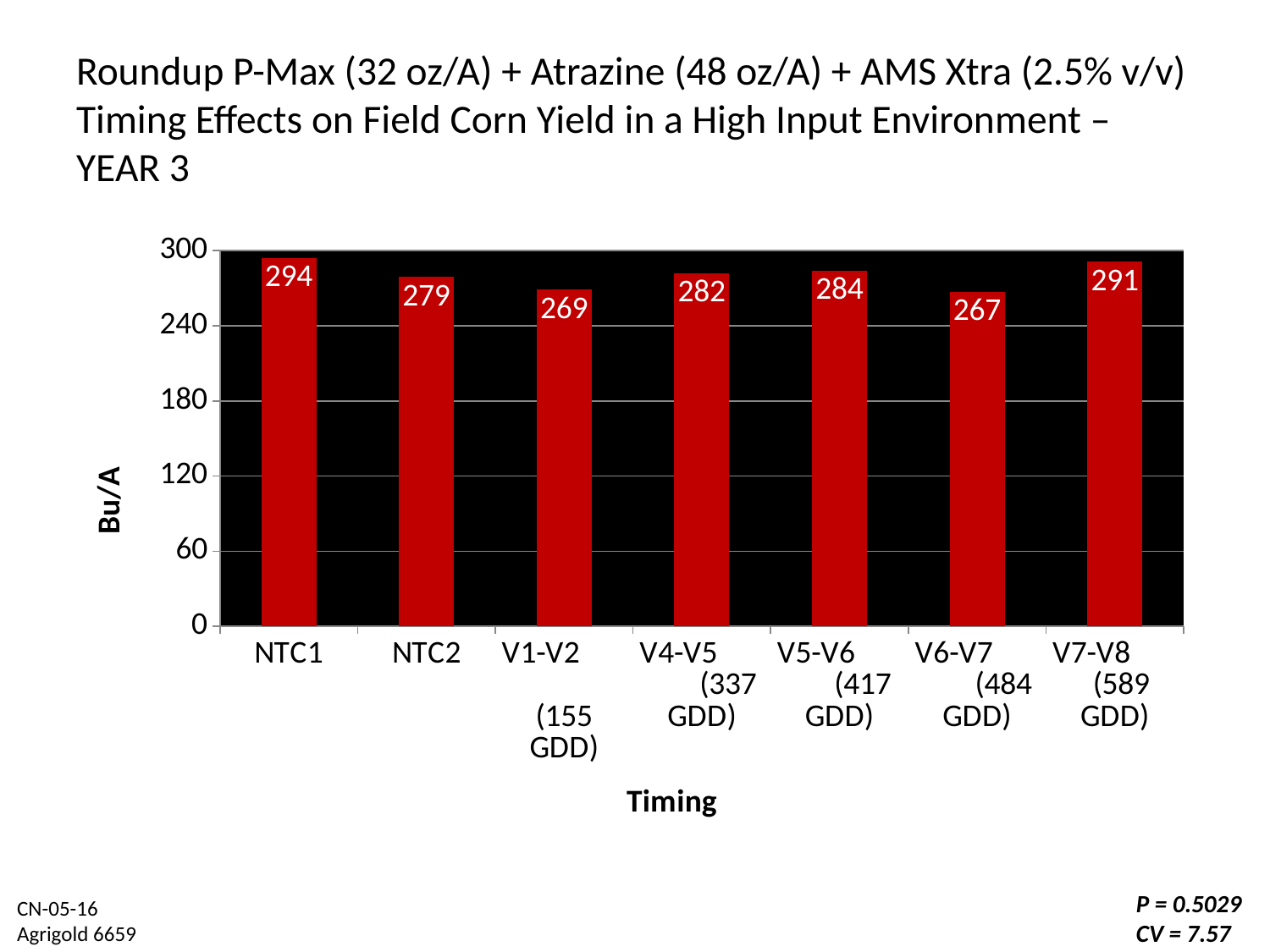
How many timing categories are shown on the x axis? 7 Which timing has the highest yield? NTC1 What is the difference in yield between NTC1 and NTC2? 15 What kind of chart is shown on the slide? bar chart What is the yield value for V4-V5 (337 GDD)? 282 Which has a higher yield, V4-V5 (337 GDD) or V6-V7 (484 GDD)? V4-V5 (337 GDD) What is the label of the y axis? Bu/A Which timing has the lowest yield? V6-V7 (484 GDD) What is the yield value for NTC1? 294 Is the value for V1-V2 (155 GDD) greater or less than 240? greater What is the difference in yield between V5-V6 (417 GDD) and V1-V2 (155 GDD)? 15 What is the yield value for V7-V8 (589 GDD)? 291